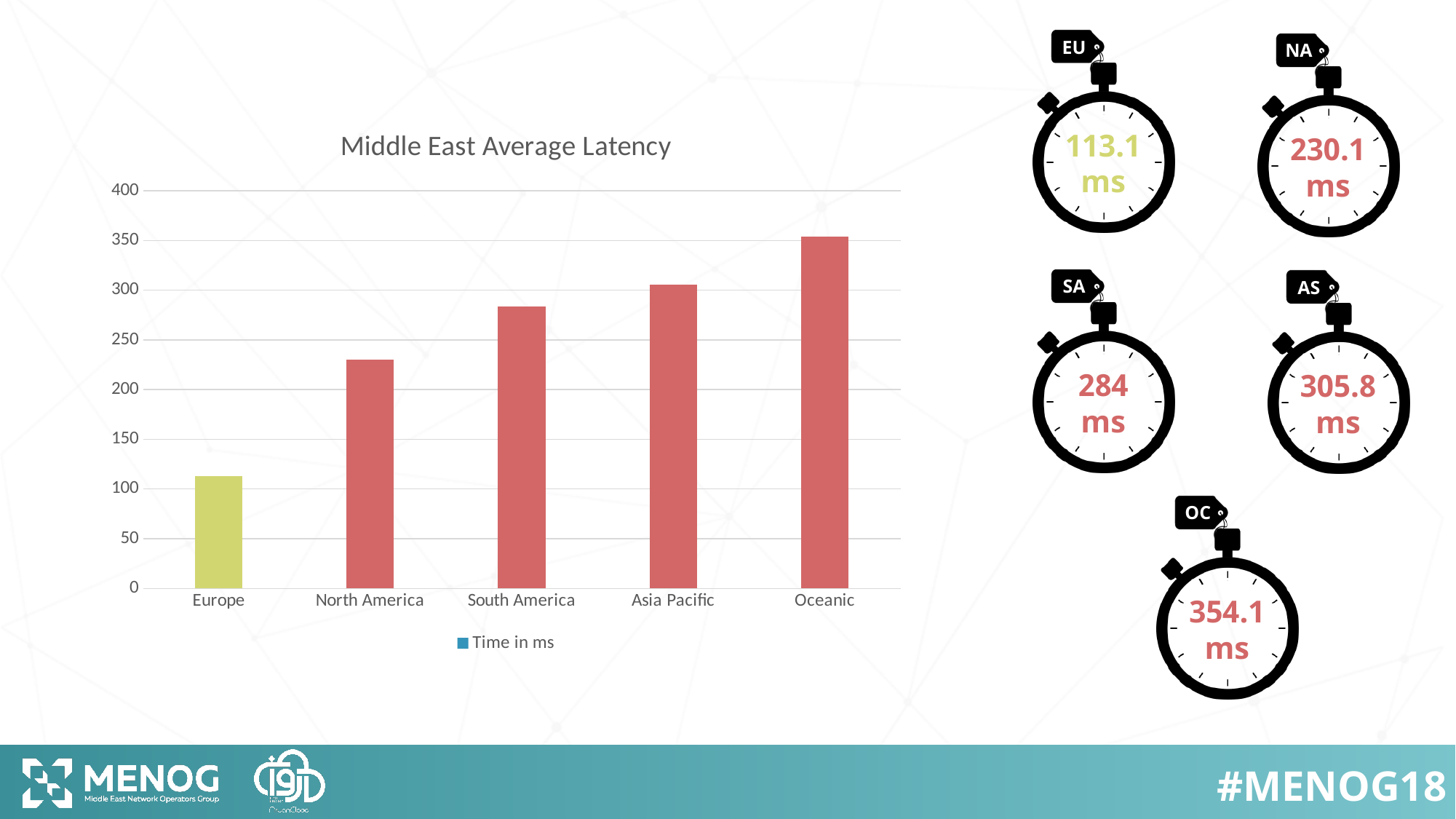
What is the legend entry for the series in the chart? Time in ms Is the value for Europe greater or less than 150? less What is the title of the chart? Middle East Average Latency Is the value for Oceanic greater or less than 350? greater How many series does the chart legend list? 1 Is the value for South America greater or less than 250? greater What type of chart is shown on the slide? bar chart Which region has the lowest average latency in the chart? Europe Which is larger, the value for North America or the value for Asia Pacific? Asia Pacific How many regions are plotted in the chart? 5 Which region has the highest average latency in the chart? Oceanic Do the values rise or fall moving from Europe to Oceanic along the x axis? rise